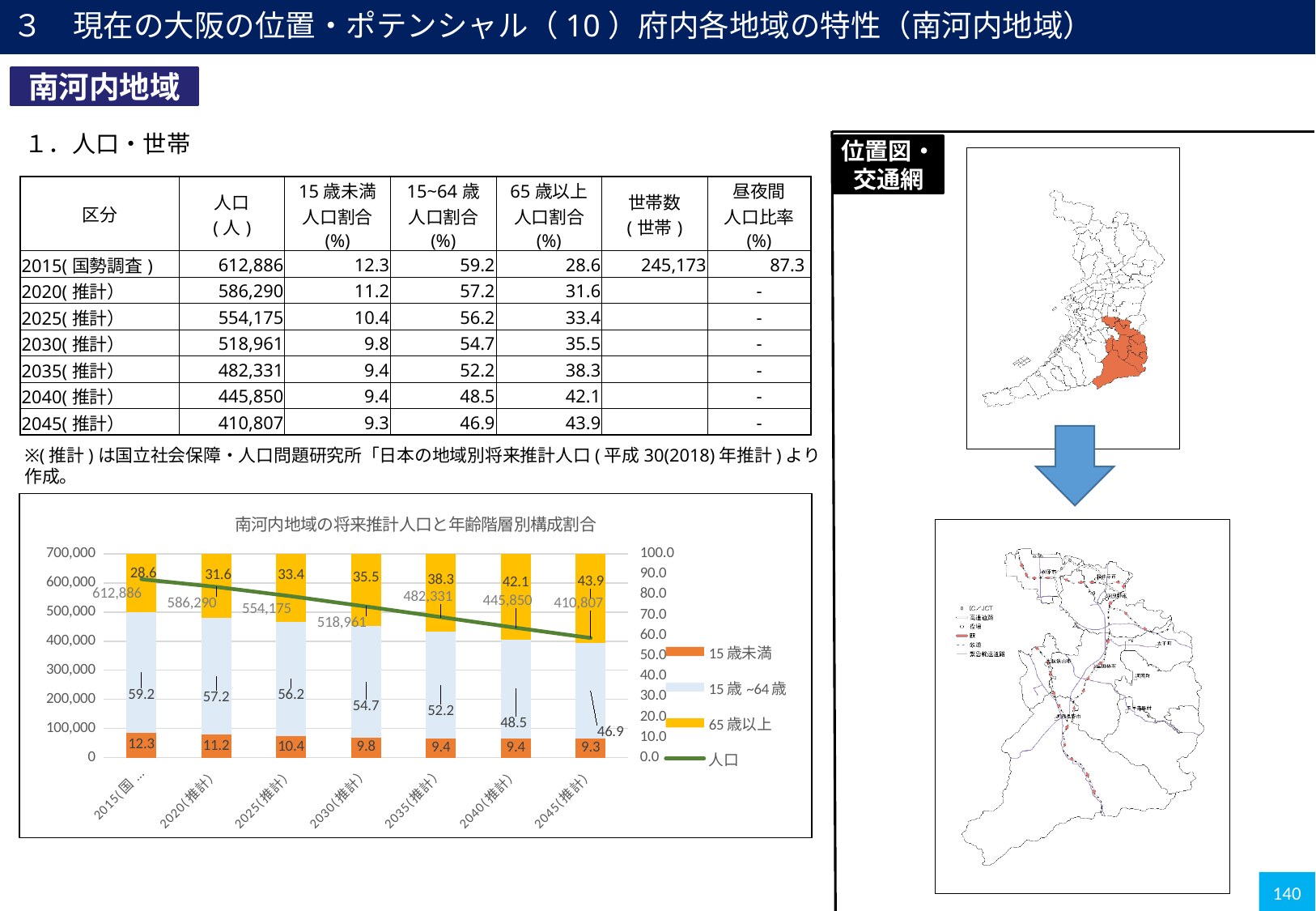
How many year categories are shown on the x axis of the chart? 7 What kind of chart is shown on the slide? Stacked bar chart with a line In the chart, what is the 15歳~64歳 share for 2035(推計)? 52.2 In the chart, does the 人口 line rise or fall from 2015 to 2045(推計)? Fall In the chart, which year has the highest 65歳以上 share? 2045(推計) In the chart, which is larger: the 15歳~64歳 share for 2020(推計) or for 2040(推計)? 2020(推計) In the chart 南河内地域の将来推計人口と年齢階層別構成割合, what is the 65歳以上 share for 2045(推計)? 43.9 In the chart, what is the difference between the 人口 value for 2015 and for 2045(推計)? 202,079 In the chart, by how much does the 65歳以上 share for 2045(推計) exceed that for 2015? 15.3 In the chart, what is the 人口 value shown for 2030(推計)? 518,961 In the chart, which year has the lowest 15歳未満 share? 2045(推計) How many entries does the chart's legend list? 4